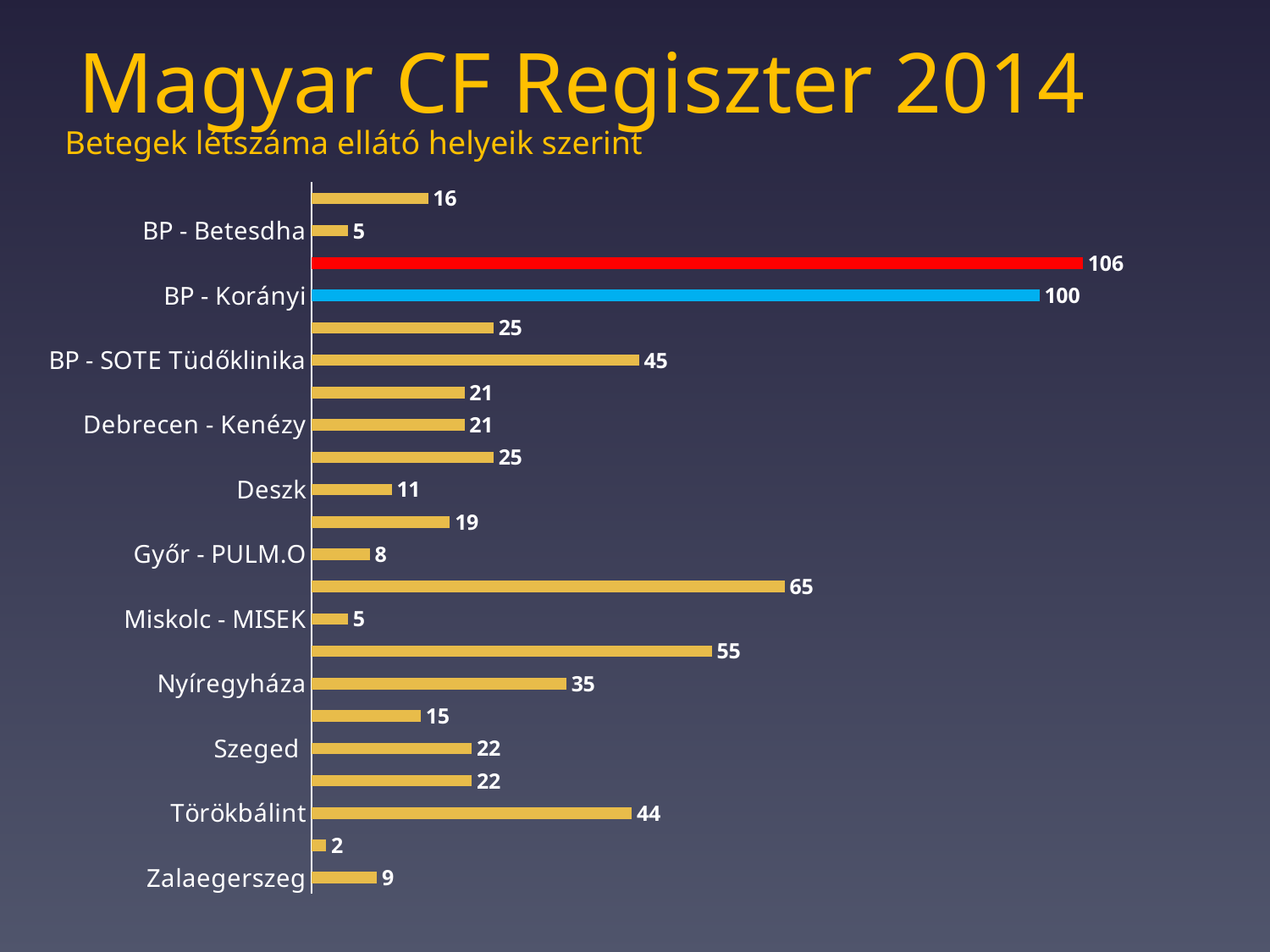
What is the value of the bar labelled Nyíregyháza? 35 What is the smallest value shown on the chart? 2 What is the value of the bar labelled BP - Korányi? 100 What is the largest value shown on the chart? 106 What is the value of the bar labelled Deszk? 11 What is the value of the bar labelled BP - SOTE Tüdőklinika? 45 What is the difference between the values for BP - Korányi and Törökbálint? 56 Which has a larger value, Nyíregyháza or Szeged? Nyíregyháza How many bars are plotted on the chart? 22 What kind of chart is shown on the slide? bar chart What is the value of the bar labelled Törökbálint? 44 What colour is the bar with the value 106? red